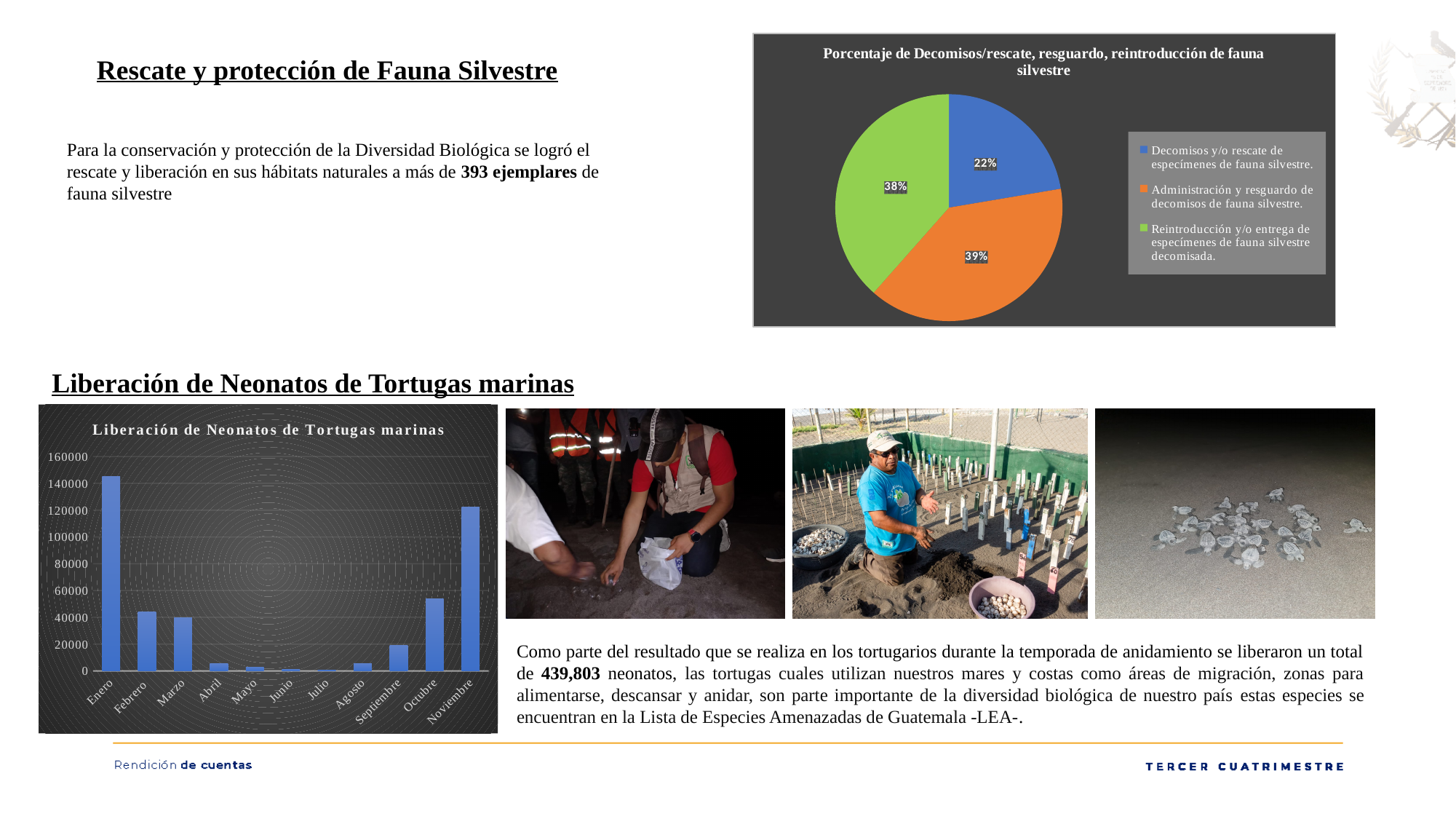
In the chart 'Liberación de Neonatos de Tortugas marinas', which is larger, the value for Octubre or the value for Febrero? Octubre In the chart 'Liberación de Neonatos de Tortugas marinas', how many months are shown on the x axis? 11 In the pie chart at the top right, how many categories does the legend list? 3 In the pie chart at the top right, which category has the smallest share? Decomisos y/o rescate de especímenes de fauna silvestre In the pie chart at the top right, what colour is the slice for 'Reintroducción y/o entrega de especímenes de fauna silvestre decomisada'? Green In the pie chart at the top right, what is the difference in percentage points between 'Administración y resguardo de decomisos de fauna silvestre' and 'Decomisos y/o rescate de especímenes de fauna silvestre'? 17 percentage points In the pie chart titled 'Porcentaje de Decomisos/rescate, resguardo, reintroducción de fauna silvestre', what percentage is shown for 'Decomisos y/o rescate de especímenes de fauna silvestre'? 22% What kind of chart is 'Liberación de Neonatos de Tortugas marinas' at the bottom left? Bar chart In the pie chart titled 'Porcentaje de Decomisos/rescate, resguardo, reintroducción de fauna silvestre', what percentage is shown for 'Administración y resguardo de decomisos de fauna silvestre'? 39% In the chart 'Liberación de Neonatos de Tortugas marinas', is the value for Noviembre greater or less than 100000? greater In the chart 'Liberación de Neonatos de Tortugas marinas', which month has the highest value? Enero In the pie chart titled 'Porcentaje de Decomisos/rescate, resguardo, reintroducción de fauna silvestre', what percentage is shown for 'Reintroducción y/o entrega de especímenes de fauna silvestre decomisada'? 38%